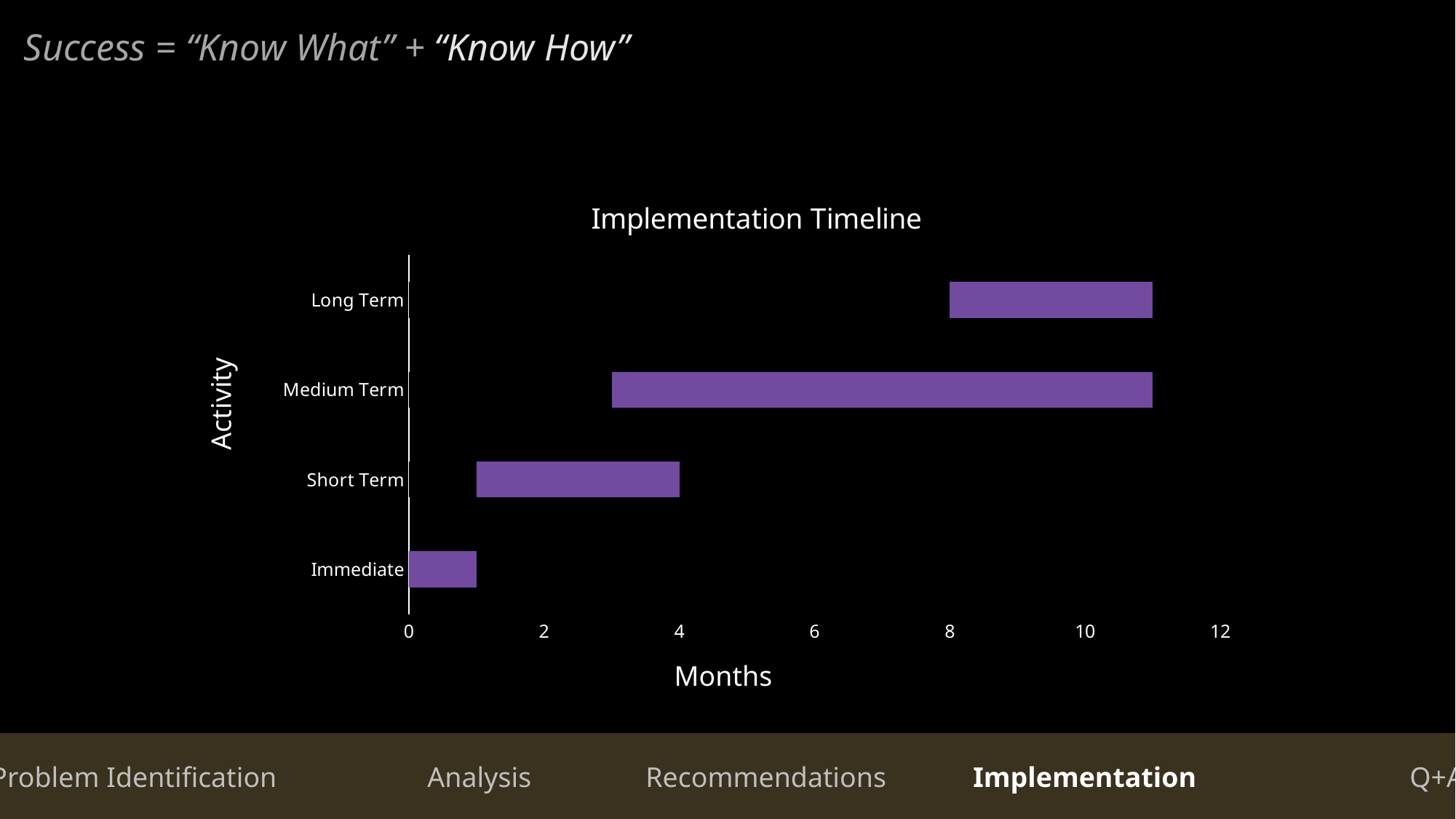
Is the end of the Medium Term bar greater or less than 10 months? greater At what month does the Short Term bar end? 4 Which activity has the longest bar on the chart? Medium Term Is the end of the Long Term bar greater or less than 12 months? less Is the end of the Immediate bar greater or less than 2 months? less What is the title of the chart? Implementation Timeline How many activities are plotted on the chart? 4 Which activity has the shortest bar on the chart? Immediate What kind of chart is shown on the slide? bar chart Which bar spans more months, Short Term or Long Term? Neither; both span 3 months What is the label of the horizontal axis? Months At what month does the Long Term bar start? 8